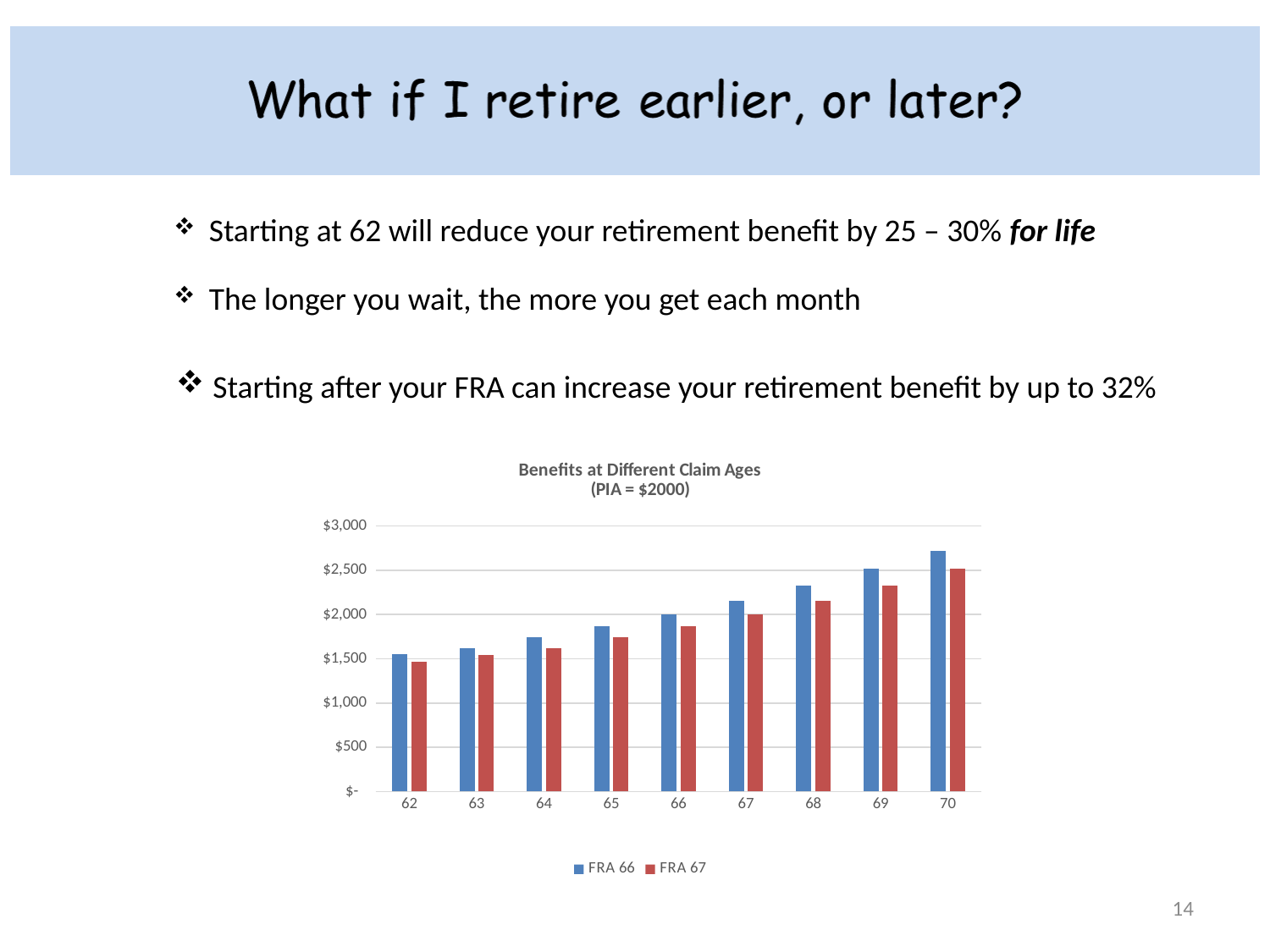
Which claim age has the highest FRA 66 benefit? 70 What type of chart is shown on the slide? bar chart Which claim age has the lowest FRA 67 benefit? 62 Is the FRA 66 benefit at claim age 70 greater or less than $2,500? greater At claim age 70, which series has the larger benefit, FRA 66 or FRA 67? FRA 66 How many series does the chart legend list? 2 What is the FRA 67 benefit at claim age 67? $2,000 What is the title of the chart? Benefits at Different Claim Ages (PIA = $2000) Do the benefit values rise or fall as claim age increases along the x axis? rise How many claim ages are shown on the x axis of the chart? 9 What is the FRA 66 benefit at claim age 66? $2,000